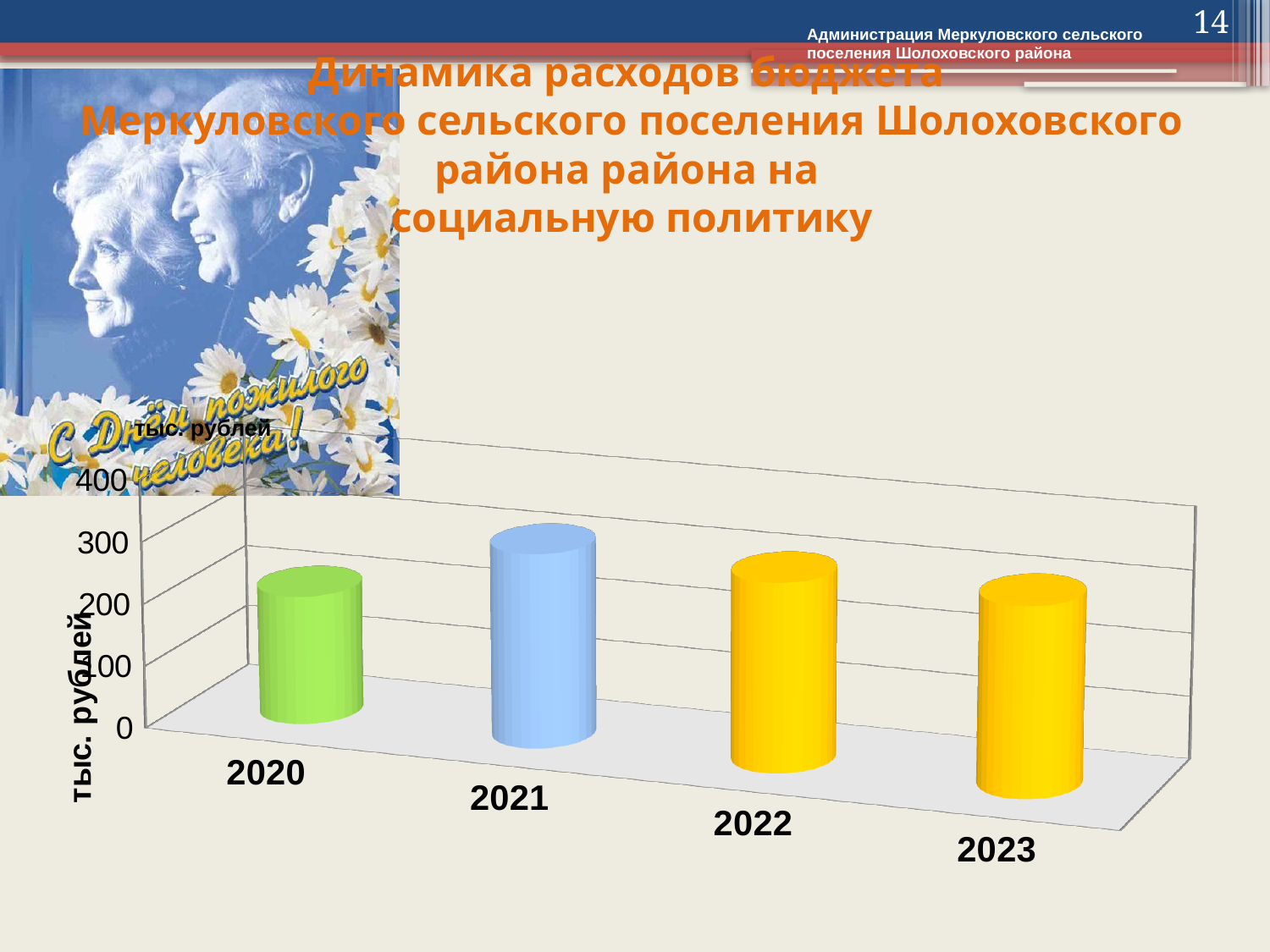
Is the value for 2020 greater or less than 300? less What is the highest tick value shown on the vertical axis? 400 Is the value for 2023 greater or less than 100? greater Which is larger, the value for 2020 or the value for 2021? 2021 Is the value for 2020 greater or less than 100? greater What unit is shown on the vertical axis of the chart? тыс. рублей Which year has the lowest value in the chart? 2020 What kind of chart is shown on the slide? Bar chart How many years are shown on the x axis of the chart? 4